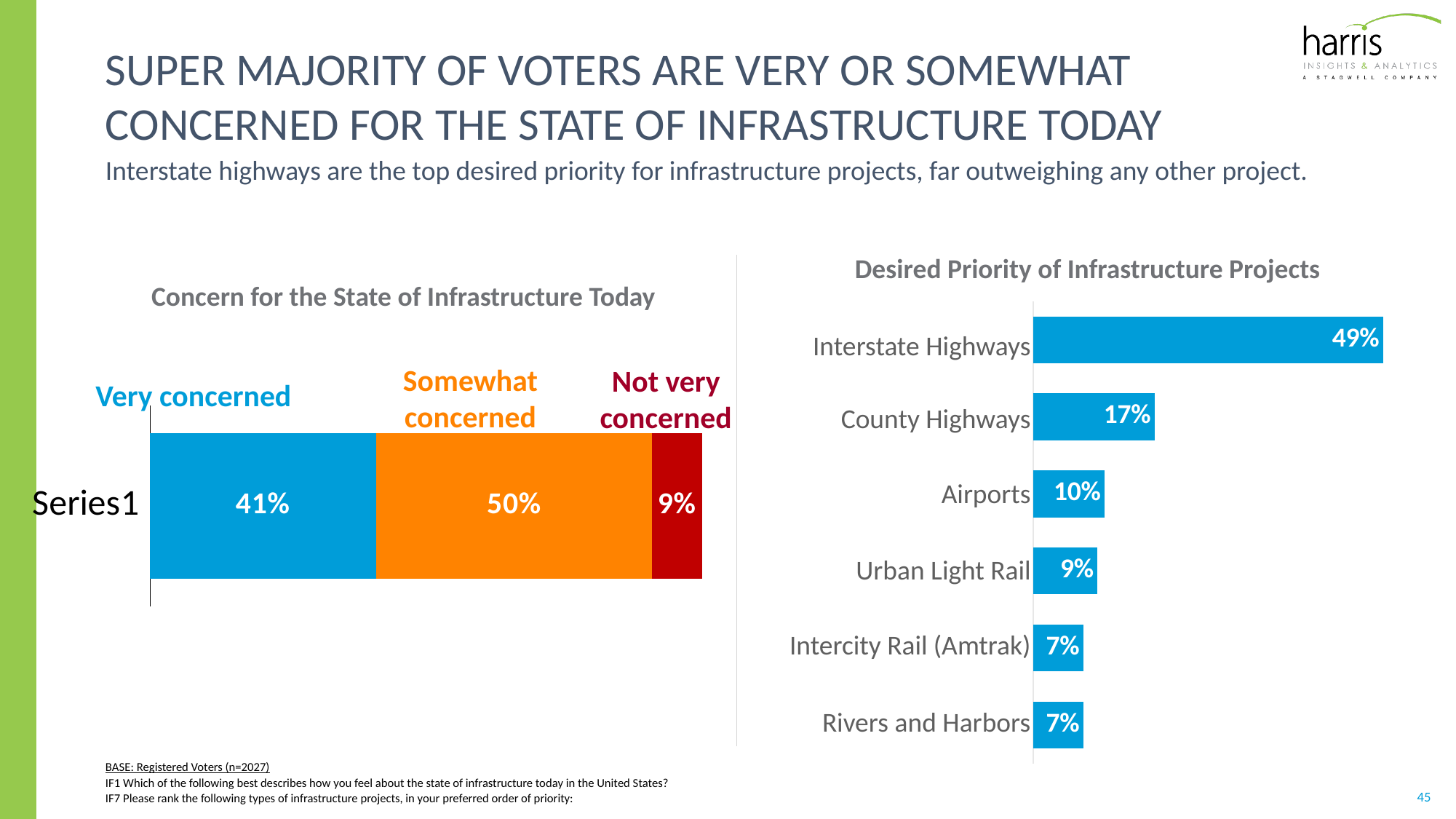
What type of chart is the 'Desired Priority of Infrastructure Projects' chart? Bar chart In the 'Desired Priority of Infrastructure Projects' chart, which project has the highest percentage? Interstate Highways In the 'Concern for the State of Infrastructure Today' chart, how many response categories are shown in the stacked bar? 3 In the 'Desired Priority of Infrastructure Projects' chart, how many infrastructure project categories are listed? 6 In the 'Concern for the State of Infrastructure Today' chart, what is the combined percentage of very concerned and somewhat concerned voters? 91% In the 'Concern for the State of Infrastructure Today' chart, what percentage of voters are very concerned? 41% In the 'Concern for the State of Infrastructure Today' chart, what percentage of voters are somewhat concerned? 50% In the 'Desired Priority of Infrastructure Projects' chart, which is larger, Airports or Intercity Rail (Amtrak)? Airports In the 'Desired Priority of Infrastructure Projects' chart, what percentage is shown for Interstate Highways? 49% In the 'Desired Priority of Infrastructure Projects' chart, what is the difference between Interstate Highways and County Highways? 32% In the 'Concern for the State of Infrastructure Today' chart, which response category has the largest share? Somewhat concerned In the 'Desired Priority of Infrastructure Projects' chart, what percentage is shown for Urban Light Rail? 9%